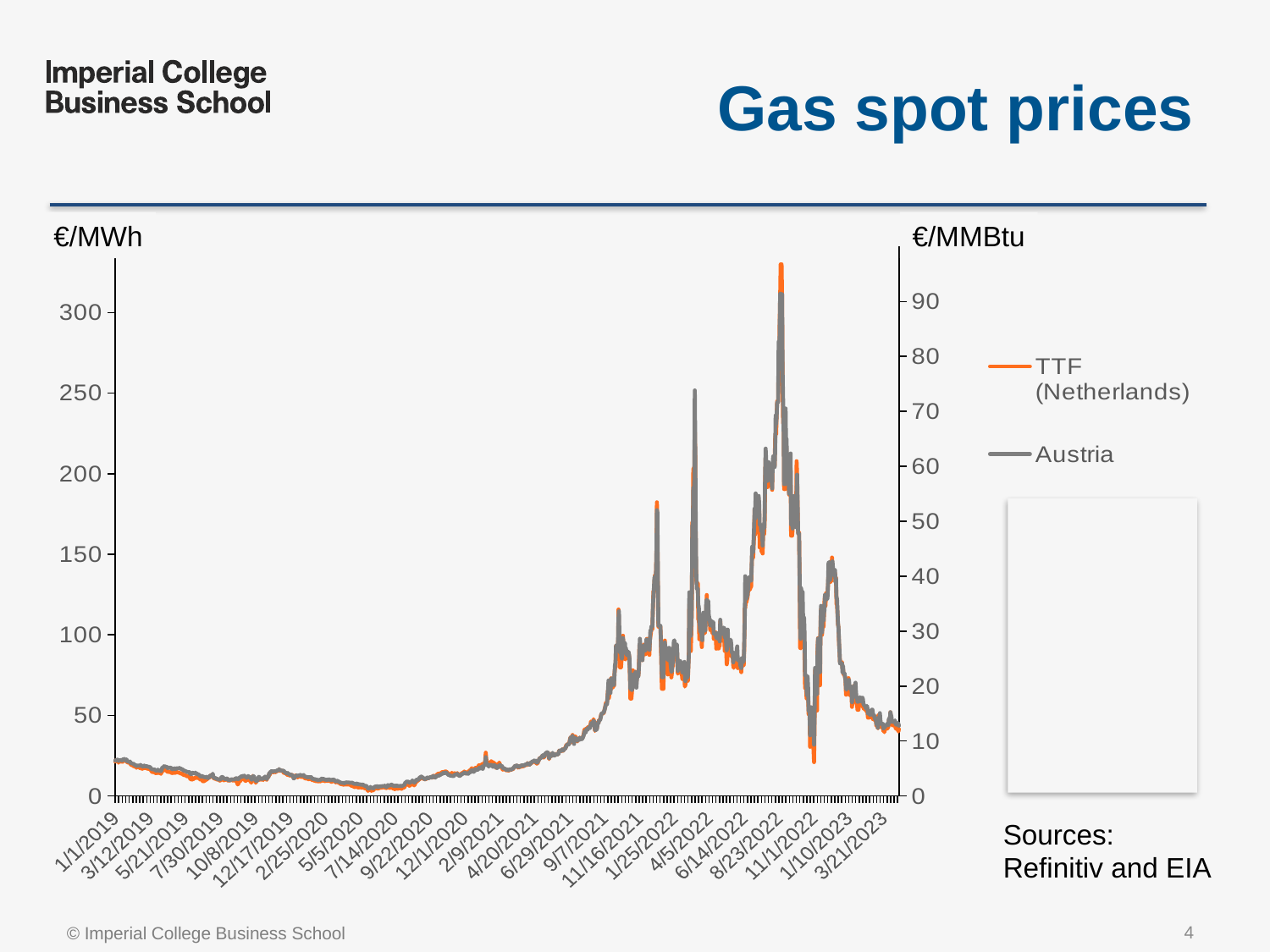
What are the two series named in the legend? TTF (Netherlands) and Austria Do the gas spot prices rise or fall between 8/23/2022 and 3/21/2023? fall What is the title of the chart? Gas spot prices Which series is the highest at its 2022 peak, TTF (Netherlands) or Austria, or are they too close to tell? too close to tell Is the peak value of the Austria series in 2022 greater or less than 300 €/MWh? greater How many series does the legend list? 2 Is the value for Austria around 7/14/2020 greater or less than 50 €/MWh? less Is the value for TTF (Netherlands) on 1/1/2019 greater or less than 50 €/MWh? less Do the gas spot prices rise or fall between 7/14/2020 and 8/23/2022? rise What kind of chart is shown on the slide? line chart